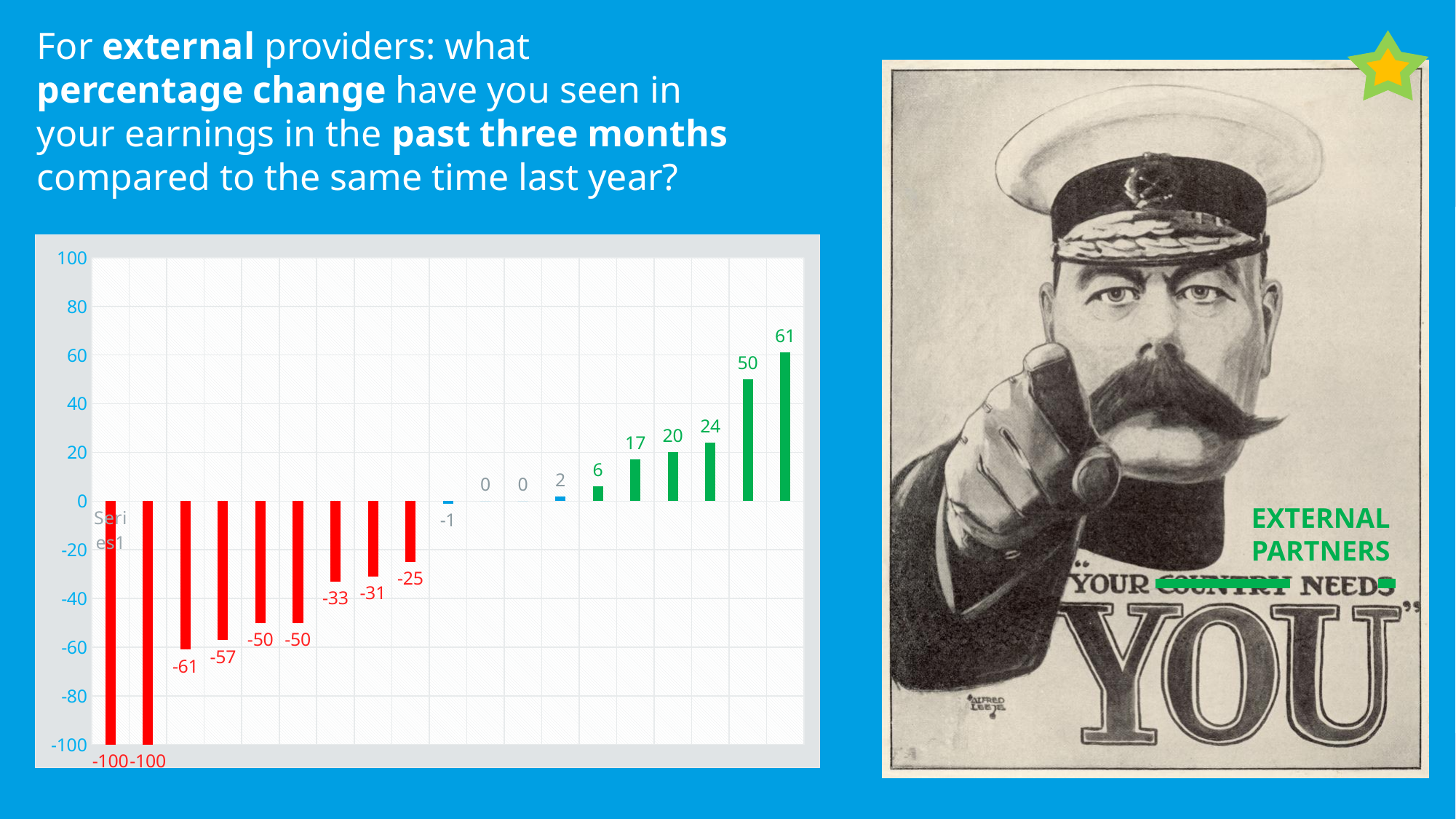
What is the value of the rightmost bar in the chart? 61 How many bars in the chart are coloured green? 6 What kind of chart is shown on the slide? bar chart What is the lowest value shown in the bar chart? -100 What is the value of the leftmost bar in the chart? -100 What is the maximum value shown on the chart's vertical axis? 100 What is the difference between the two rightmost bars (61 and 50)? 11 How many bars in the chart are coloured red (negative values)? 9 How many bars are plotted in the chart? 19 Which is larger: the third bar from the left (-61) or the fourth bar from the left (-57)? the fourth bar (-57) What is the highest value shown in the bar chart? 61 Do the bar values rise or fall from left to right across the chart? rise